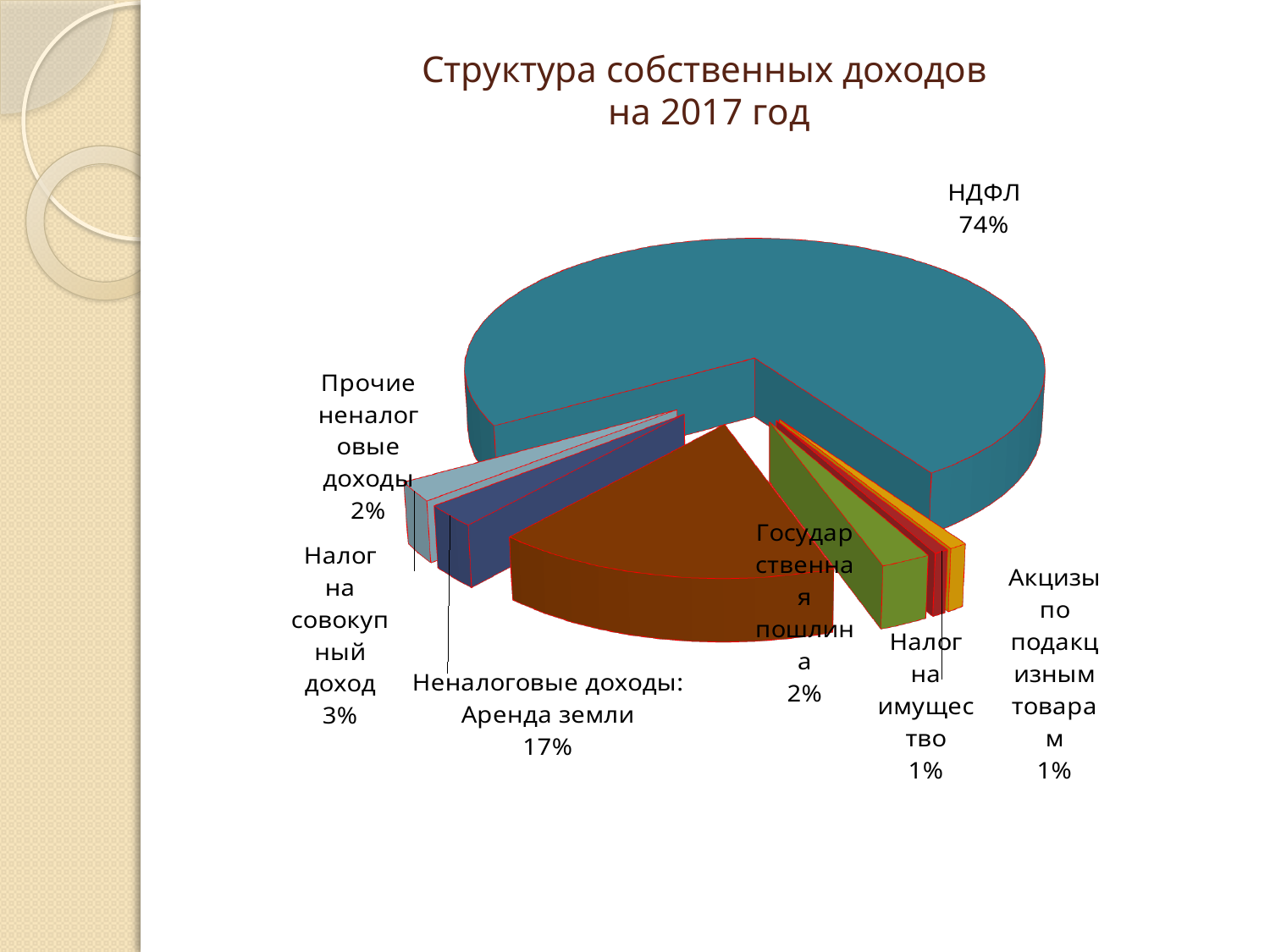
What is the value shown for Прочие неналоговые доходы? 2% How many slices does the pie chart have? 7 What is the value shown for Государственная пошлина? 2% What share of the pie does НДФЛ account for? 74% What kind of chart is shown on the slide? Pie chart What is the title of the chart? Структура собственных доходов на 2017 год What is the value shown for Налог на совокупный доход? 3% What is the value shown for Акцизы по подакцизным товарам? 1% Which is larger, the share for Налог на совокупный доход or the share for Налог на имущество? Налог на совокупный доход Which category has the largest share of the pie? НДФЛ What is the difference in percentage points between НДФЛ and Неналоговые доходы: Аренда земли? 57 What is the value shown for Неналоговые доходы: Аренда земли? 17%